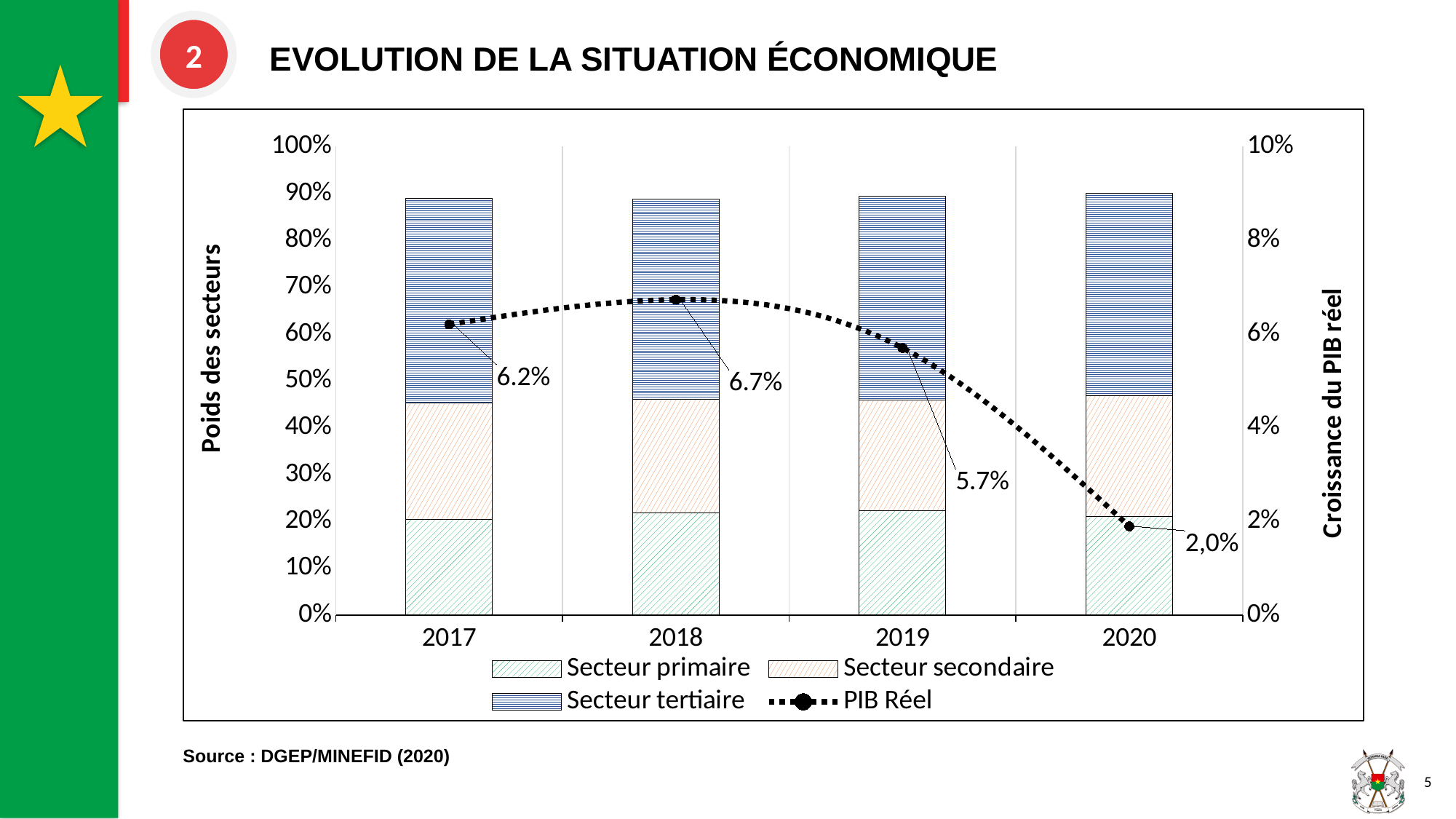
How many years are shown on the x axis? 4 How many series does the legend list? 4 Is the value for Secteur primaire in 2017 greater or less than 30%? less What is the PIB Réel value shown for 2018? 6.7% What is the title of the right-hand vertical axis? Croissance du PIB réel What is the PIB Réel value shown for 2017? 6.2% What is the PIB Réel value shown for 2020? 2,0% What is the PIB Réel value shown for 2019? 5.7% In which year is the PIB Réel growth lowest? 2020 Which year has the larger PIB Réel growth, 2017 or 2019? 2017 In which year is the PIB Réel growth highest? 2018 By how many percentage points does PIB Réel growth in 2018 exceed that of 2017? 0.5 percentage points